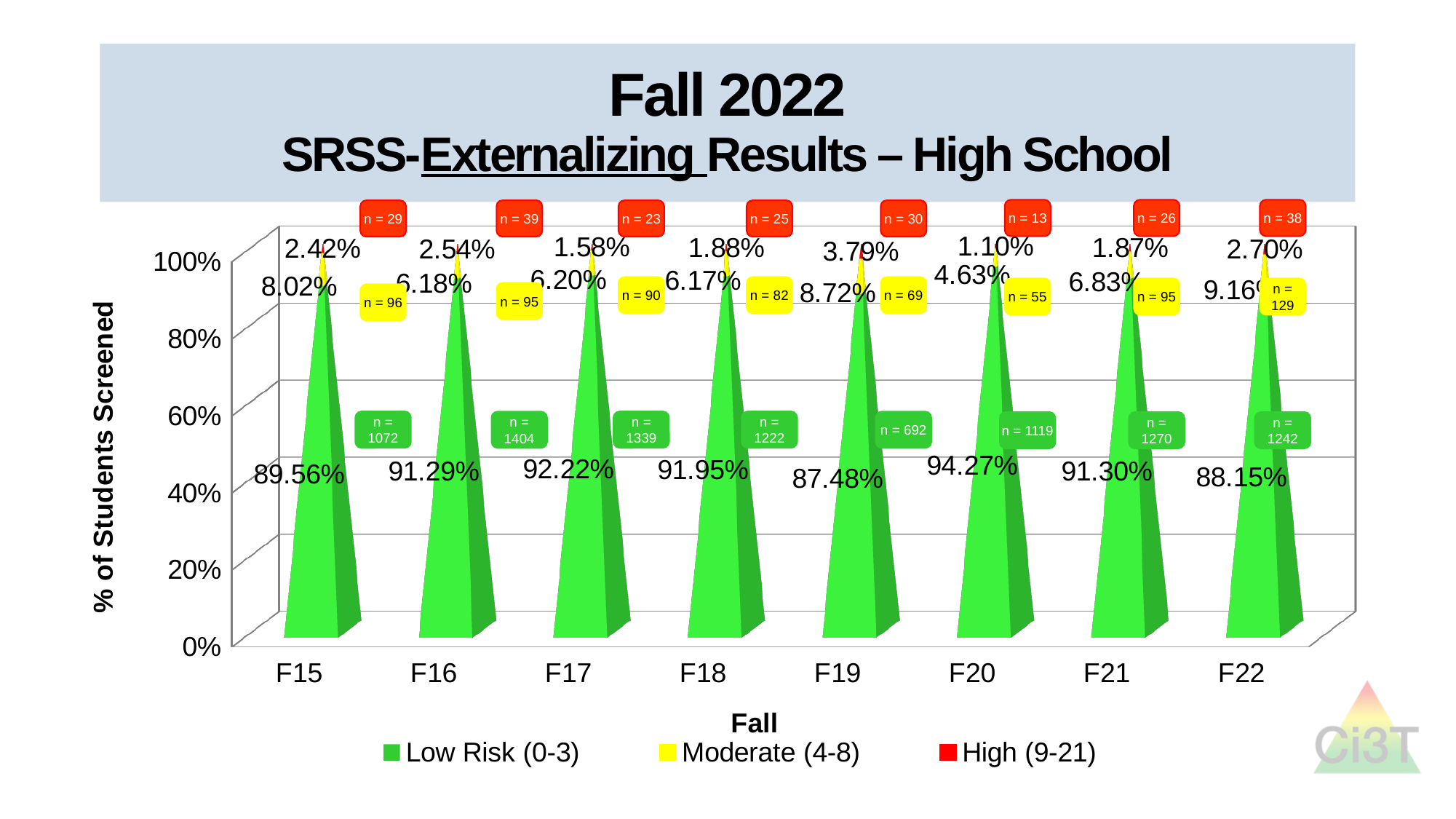
Which fall has the highest Low Risk (0-3) percentage? F20 Which fall has the lowest Low Risk (0-3) percentage? F19 What is the High (9-21) percentage for F19? 3.79% What kind of chart is shown on the slide? Stacked bar chart Is the High (9-21) percentage larger for F16 or F17? F16 What is the label of the y axis? % of Students Screened Which fall has the lowest High (9-21) percentage? F20 How many series does the legend list? 3 What is the difference between the Low Risk (0-3) percentages for F20 and F19? 6.79% What is the Low Risk (0-3) percentage for F20? 94.27% What is the Moderate (4-8) percentage for F15? 8.02% How many fall semesters are shown on the x axis? 8